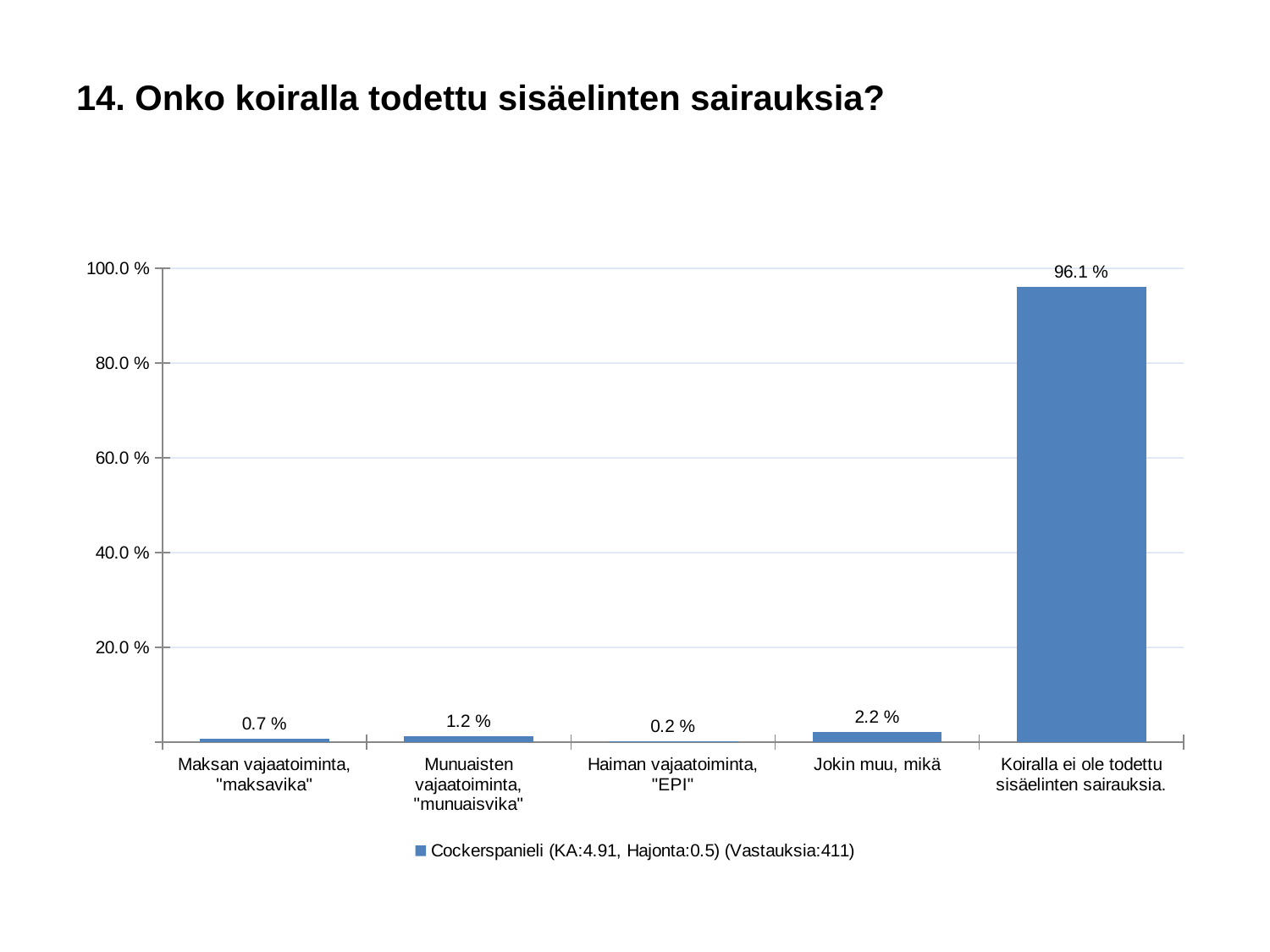
How many categories are shown on the x axis? 5 Which category has the lowest value? Haiman vajaatoiminta, "EPI" What is the value for "Jokin muu, mikä"? 2.2 % Which is larger, the value for "Munuaisten vajaatoiminta, "munuaisvika"" or the value for "Maksan vajaatoiminta, "maksavika""? Munuaisten vajaatoiminta, "munuaisvika" What is the value for "Haiman vajaatoiminta, "EPI""? 0.2 % Which category has the highest value? Koiralla ei ole todettu sisäelinten sairauksia. What is the value for "Munuaisten vajaatoiminta, "munuaisvika""? 1.2 % What kind of chart is shown on the slide? bar chart What is the title of the chart? 14. Onko koiralla todettu sisäelinten sairauksia? What is the difference between the values for "Jokin muu, mikä" and "Maksan vajaatoiminta, "maksavika""? 1.5 % Is the value for "Koiralla ei ole todettu sisäelinten sairauksia." greater or less than 80.0 %? greater What is the value for "Koiralla ei ole todettu sisäelinten sairauksia."? 96.1 %